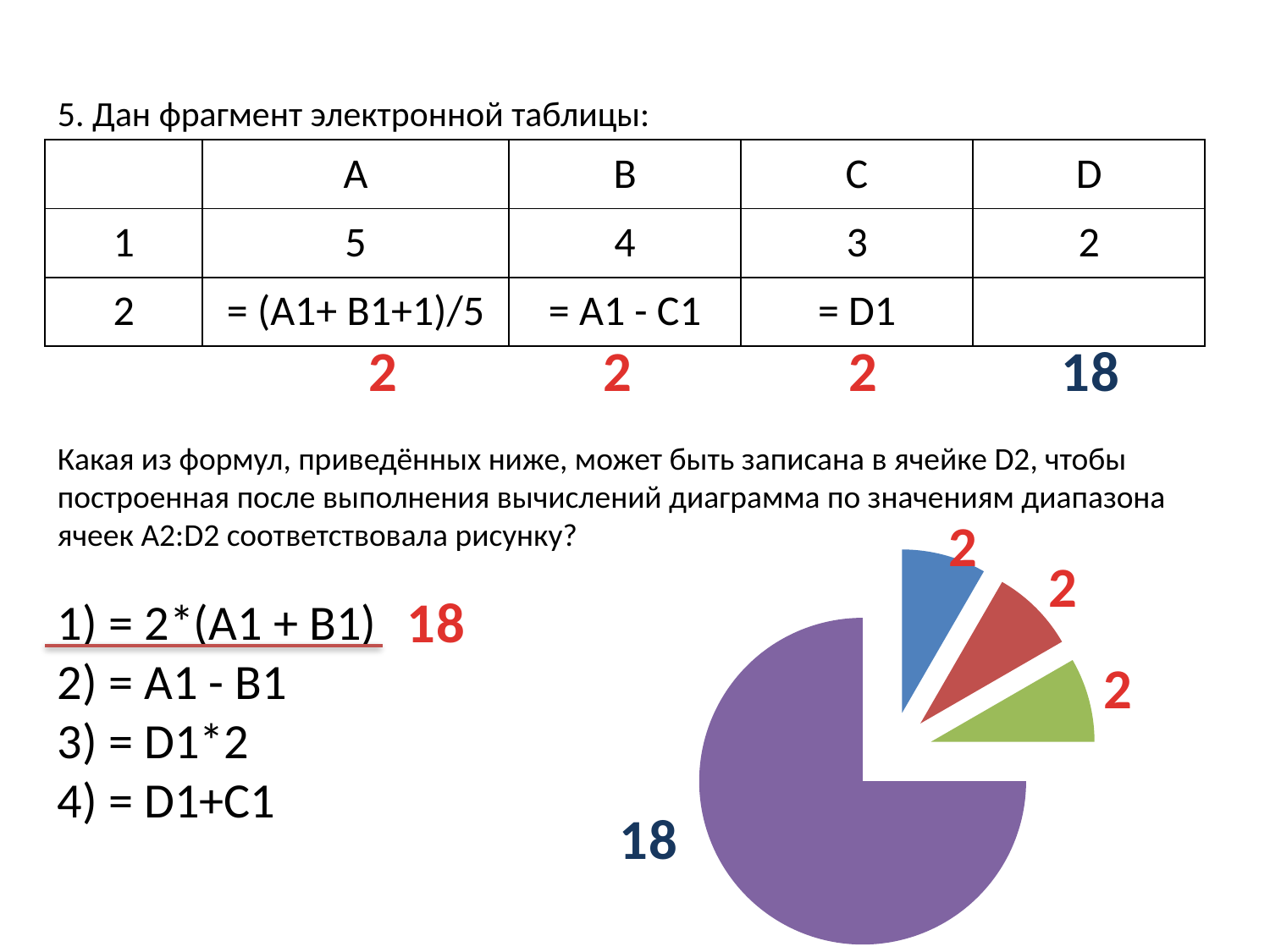
What value is labelled on the green slice of the pie chart? 2 What is the difference between the purple slice's value and the red slice's value? 16 What value is labelled on the large purple slice of the pie chart? 18 How many slices of the pie chart are labelled with the value 2? 3 Which is larger, the purple slice or the red slice? the purple slice What kind of chart is shown on the slide? pie chart What share of the pie does the purple slice (18) represent? 75% What is the total of all the slice values in the pie chart? 24 What value is labelled on the blue slice of the pie chart? 2 Does the pie chart have a legend? No How many slices does the pie chart have? 4 Which slice of the pie chart is the largest? the purple slice (18)